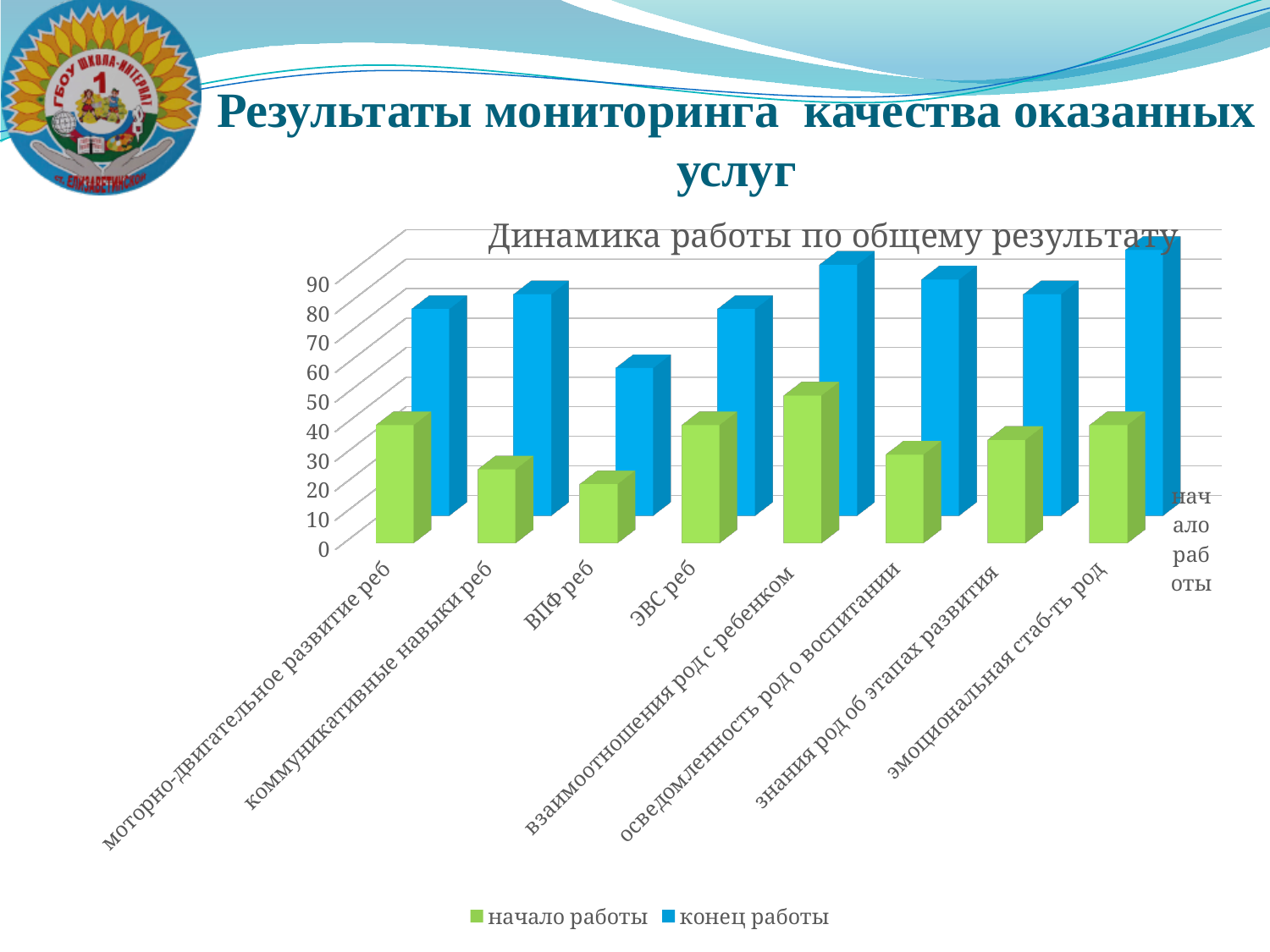
What kind of chart is shown on the slide? bar chart Which category has the lowest value for the series "конец работы"? ВПФ реб Is the value for "ВПФ реб" in the series "конец работы" greater or less than 70? less What is the title of the chart? Динамика работы по общему результату For "коммуникативные навыки реб", which series has the larger value, "начало работы" or "конец работы"? конец работы How many series does the legend list? 2 Which category has the highest value for the series "начало работы"? взаимоотношения род с ребенком Is the value for "ВПФ реб" in the series "начало работы" greater or less than 30? less How many categories are shown on the x axis of the chart? 8 Is the value for "взаимоотношения род с ребенком" in the series "конец работы" greater or less than 80? greater Which colour represents the series "конец работы" in the chart? blue